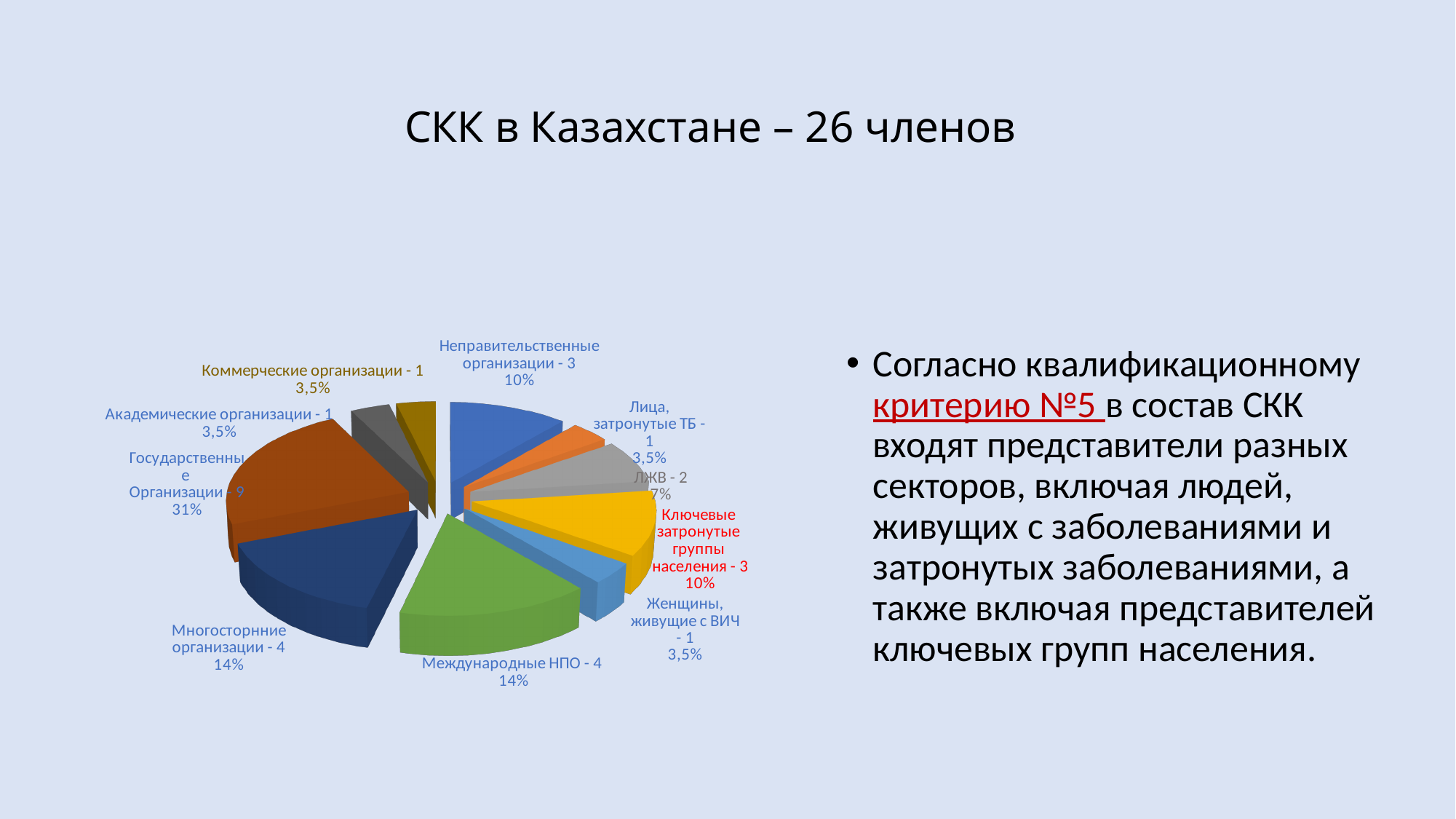
Which has more members: Многосторнние организации or Ключевые затронутые группы населения? Многосторнние организации What percentage share does Международные НПО have? 14% How many members are shown for Государственные Организации? 9 Which category has the largest share of the pie chart? Государственные Организации What is the title of the slide containing the pie chart? СКК в Казахстане – 26 членов How many members are shown for ЛЖВ? 2 How many categories (slices) does the pie chart show? 10 What percentage share does Неправительственные организации have? 10% What percentage share does Государственные Организации have in the pie chart? 31% What kind of chart is shown on the slide? pie chart What is the difference in members between Государственные Организации and Международные НПО? 5